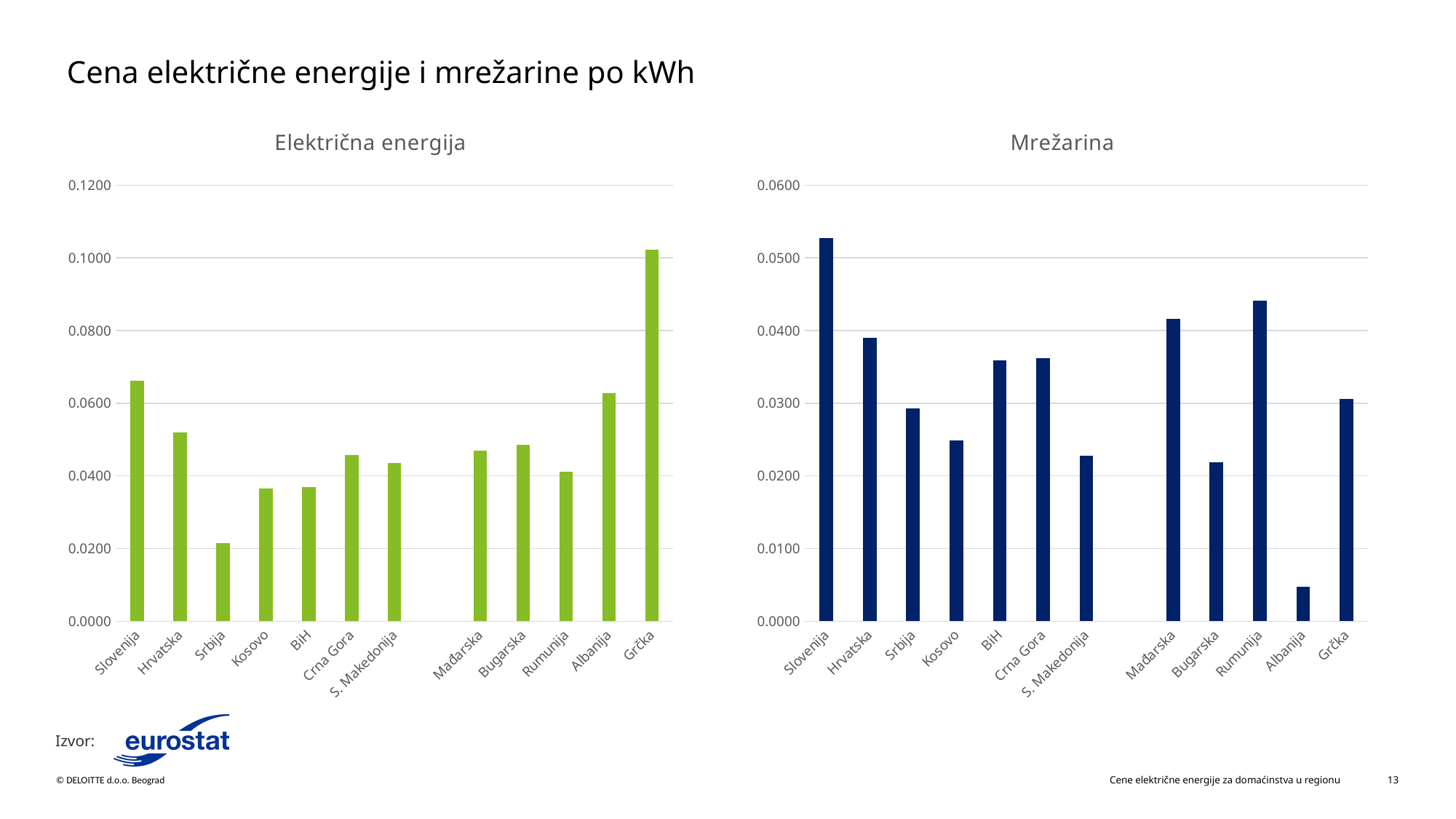
In the Električna energija chart, is the value for Grčka greater or less than 0.1000? greater In the Mrežarina chart, is the value for Albanija greater or less than 0.0100? less In the Električna energija chart, which is larger, the value for Albanija or the value for Rumunija? Albanija In the Mrežarina chart, which is larger, the value for Mađarska or the value for Bugarska? Mađarska What kind of chart is the Električna energija chart? Bar chart In the Električna energija chart, which country has the lowest value? Srbija In the Električna energija chart, is the value for Srbija greater or less than 0.0400? less In the Električna energija chart, which country has the highest value? Grčka How many countries are shown in the Mrežarina chart? 12 In the Mrežarina chart, which country has the highest value? Slovenija In the Mrežarina chart, which country has the lowest value? Albanija